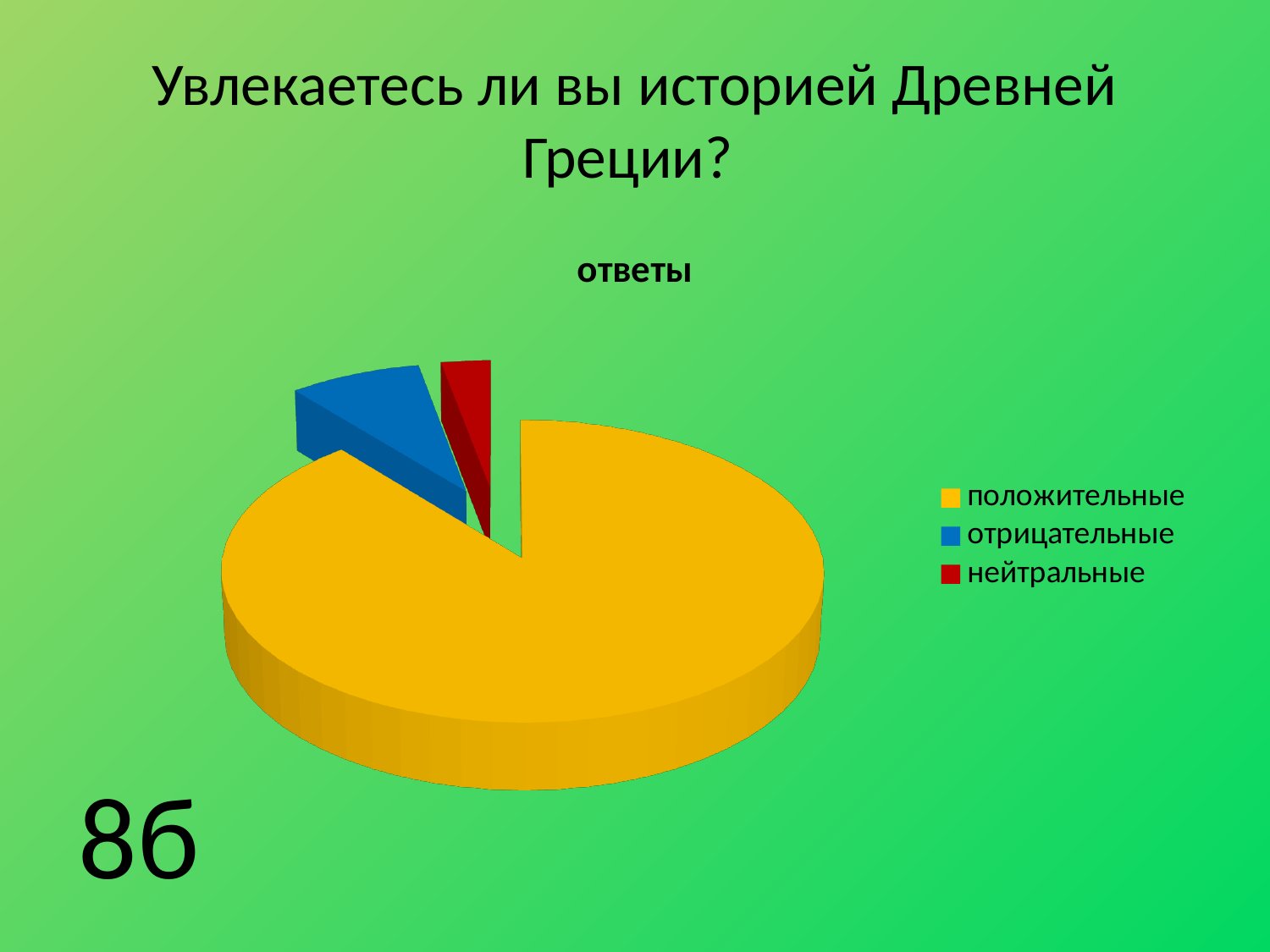
What colour is the slice for отрицательные? blue Which slice is larger, отрицательные or нейтральные? отрицательные Which category has the largest slice of the pie? положительные Which slice is larger, положительные or отрицательные? положительные What kind of chart is shown on the slide? pie chart How many entries does the legend list? 3 Which category has the smallest slice of the pie? нейтральные What is the title of the chart? ответы How many slices does the pie chart have? 3